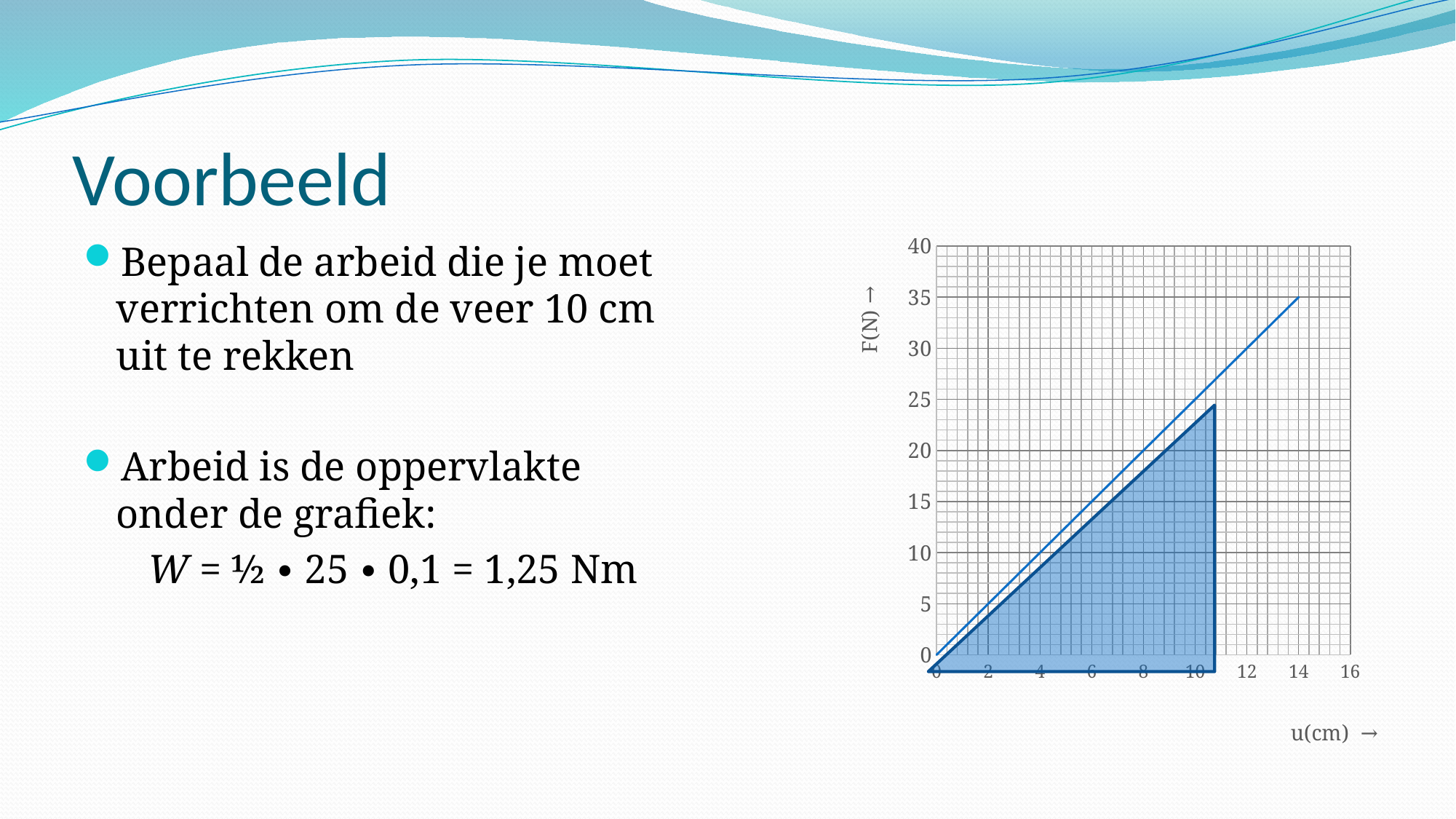
What is the highest tick value shown on the horizontal axis? 16 Is the value of F at u = 12 cm greater or less than 25? greater What is the label of the vertical axis of the chart? F(N) Does the force F rise or fall as u increases along the x axis? rises Is the value of F at u = 4 cm greater or less than 15? less Is the value of F at u = 8 cm greater or less than 15? greater What kind of chart is shown on the slide? line chart What is the label of the horizontal axis of the chart? u(cm) What is the highest tick value shown on the vertical axis? 40 What is the value of F at u = 0 cm? 0